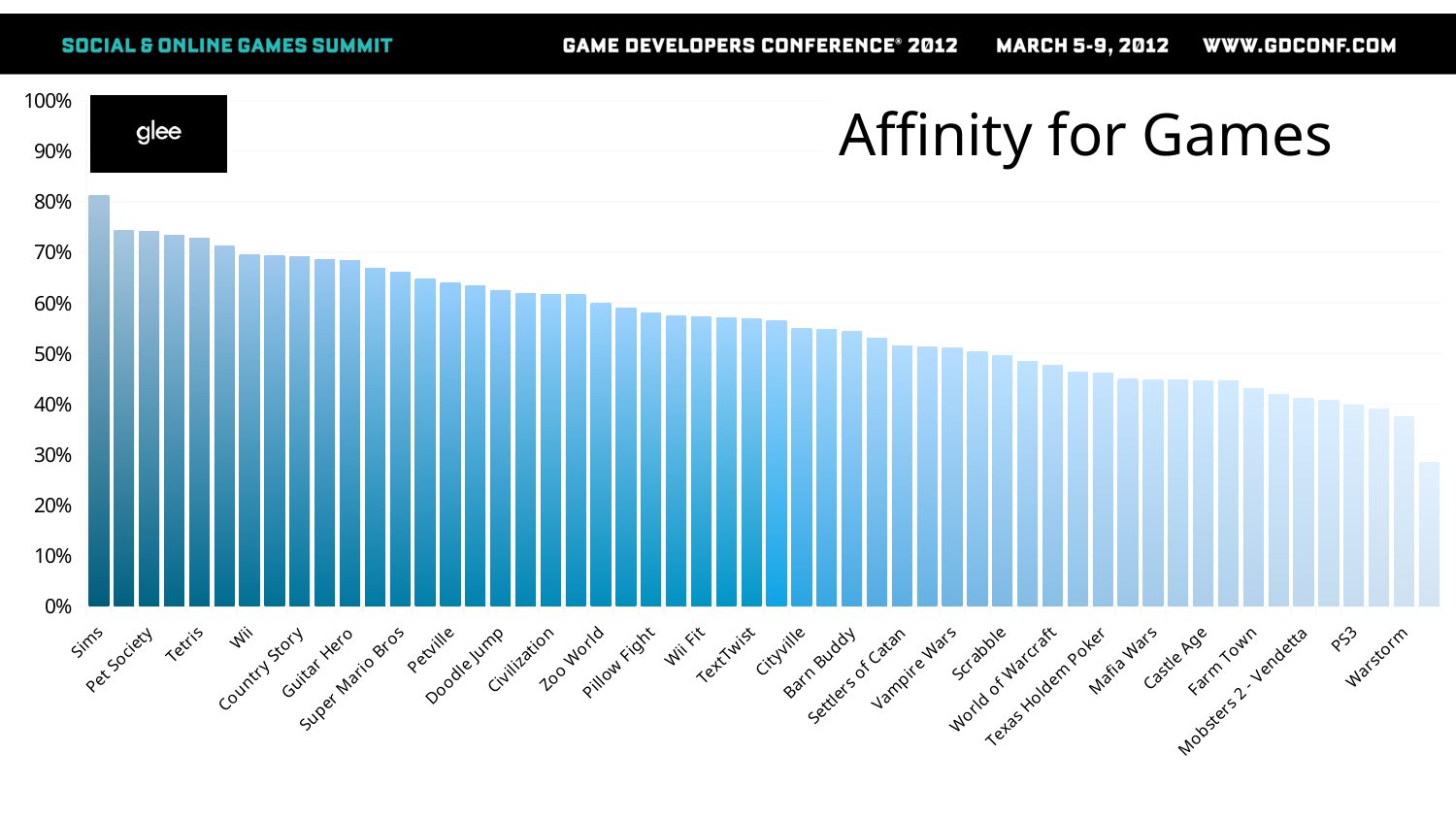
What is the title of the chart? Affinity for Games Is the value for Sims greater or less than 70%? greater Is the value for Warstorm greater or less than 40%? less Is the value for Petville greater or less than 60%? greater Which has a higher value, Sims or Warstorm? Sims What kind of chart is shown on the slide? bar chart Do the values rise or fall moving from left to right along the x axis? fall Which has a higher value, Pet Society or Farm Town? Pet Society Which game has the highest affinity value? Sims